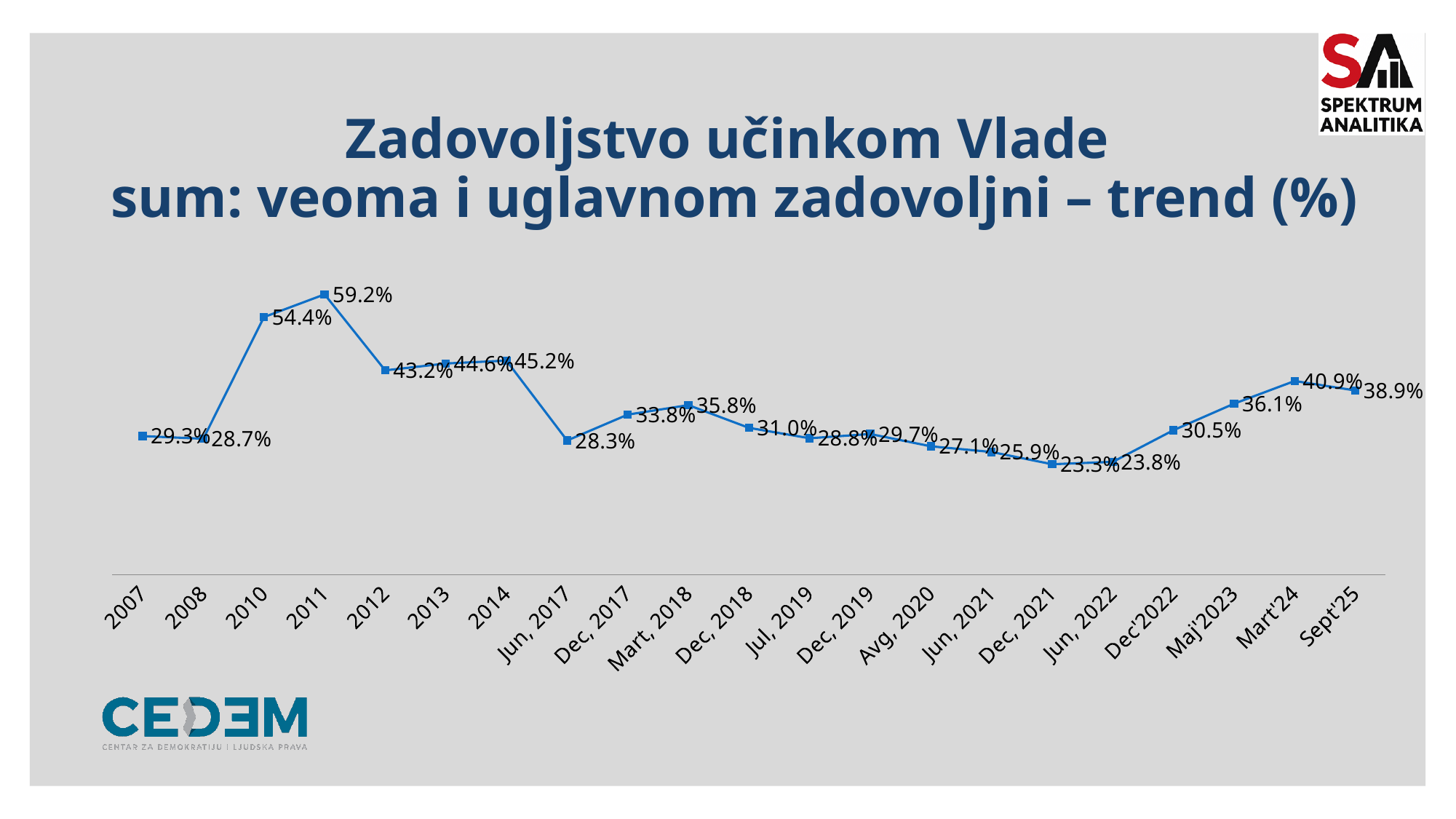
Which period has the highest value? 2011 Which is larger, the value for Mart, 2018 or the value for Dec, 2018? Mart, 2018 What is the value for 2011? 59.2% What is the value for Jun, 2017? 28.3% What is the value for Sept'25? 38.9% Do the values rise or fall from Dec, 2021 to Mart'24? Rise How many data points are plotted on the chart? 21 What is the value for Dec'2022? 30.5% What is the difference between the values for Mart'24 and Sept'25? 2.0% Which period has the lowest value? Dec, 2021 What is the difference between the values for 2011 and 2010? 4.8% What kind of chart is shown on the slide? Line chart